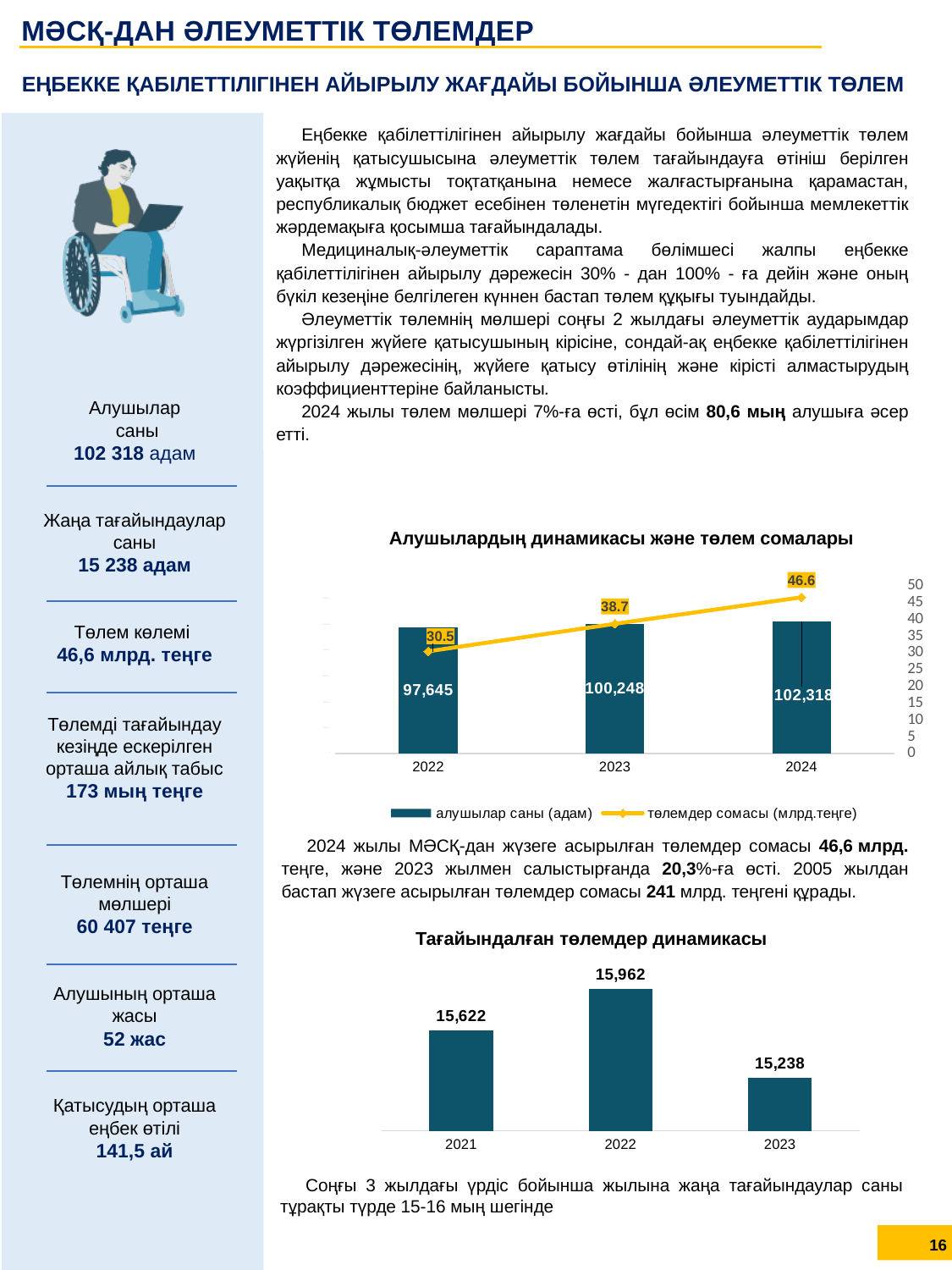
In the chart titled "Алушылардың динамикасы және төлем сомалары", which year has the highest төлемдер сомасы (млрд.теңге)? 2024 In the chart titled "Алушылардың динамикасы және төлем сомалары", what is the value of төлемдер сомасы (млрд.теңге) for 2023? 38.7 In the chart titled "Алушылардың динамикасы және төлем сомалары", what is the value of алушылар саны (адам) for 2024? 102,318 In the chart titled "Алушылардың динамикасы және төлем сомалары", how many series does the legend list? 2 In the chart titled "Алушылардың динамикасы және төлем сомалары", what is the difference in алушылар саны (адам) between 2023 and 2022? 2,603 In the chart titled "Тағайындалған төлемдер динамикасы", what is the difference between the values for 2022 and 2023? 724 In the chart titled "Тағайындалған төлемдер динамикасы", how many years are shown on the x axis? 3 What kind of chart is the chart titled "Тағайындалған төлемдер динамикасы"? bar chart In the chart titled "Тағайындалған төлемдер динамикасы", what is the value for 2022? 15,962 In the chart titled "Алушылардың динамикасы және төлем сомалары", does алушылар саны (адам) rise or fall from 2022 to 2024? rise In the chart titled "Алушылардың динамикасы және төлем сомалары", what is the difference in төлемдер сомасы (млрд.теңге) between 2024 and 2022? 16.1 In the chart titled "Тағайындалған төлемдер динамикасы", which year has the lowest value? 2023